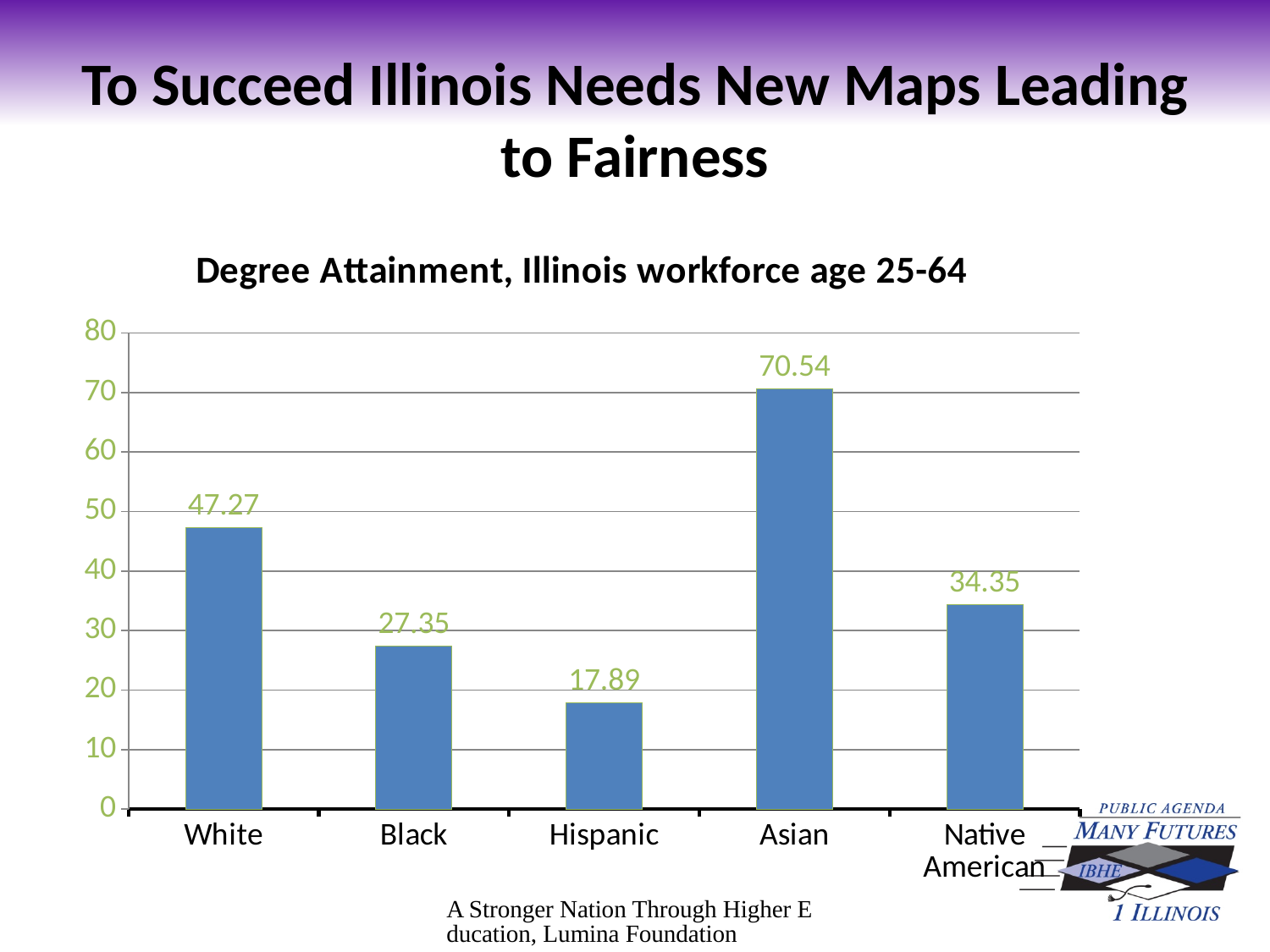
Which is larger, the value for Black or the value for Native American? Native American Which category has the highest degree attainment? Asian Is the value for Black greater or less than 30? less How many categories are shown on the x axis? 5 What is the difference between the values for Asian and White? 23.27 What is the degree attainment value for White in the chart? 47.27 Which category has the lowest degree attainment? Hispanic What is the title of the chart? Degree Attainment, Illinois workforce age 25-64 What kind of chart is shown on the slide? bar chart What is the degree attainment value for Hispanic? 17.89 What is the difference between the values for Native American and Black? 7 What is the value shown for Native American? 34.35